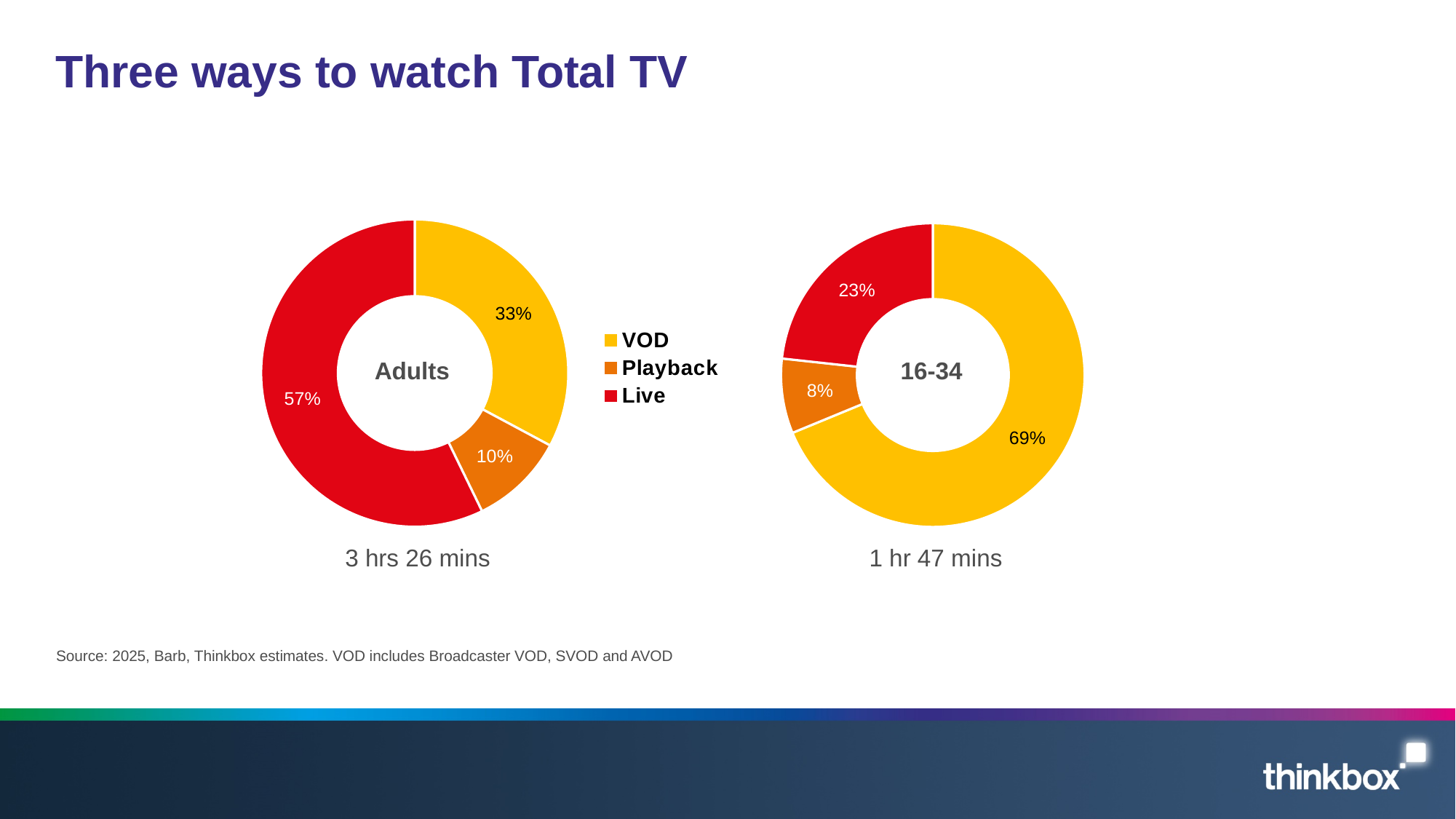
In the Adults chart, what share of viewing is Playback? 10% In the 16-34 chart, what share of viewing is Live? 23% In the 16-34 chart, which category has the smallest share? Playback In the 16-34 chart, what share of viewing is VOD? 69% In the 16-34 chart, what share of viewing is Playback? 8% In the Adults chart, what share of viewing is Live? 57% What kind of chart is used on this slide? Doughnut (pie) chart In the Adults chart, which category has the largest share? Live What is the difference between the VOD share in the 16-34 chart and the VOD share in the Adults chart? 36 percentage points How many categories does the legend list? 3 Which is larger: the Live share in the Adults chart or the Live share in the 16-34 chart? Adults In the Adults chart, what share of viewing is VOD? 33%